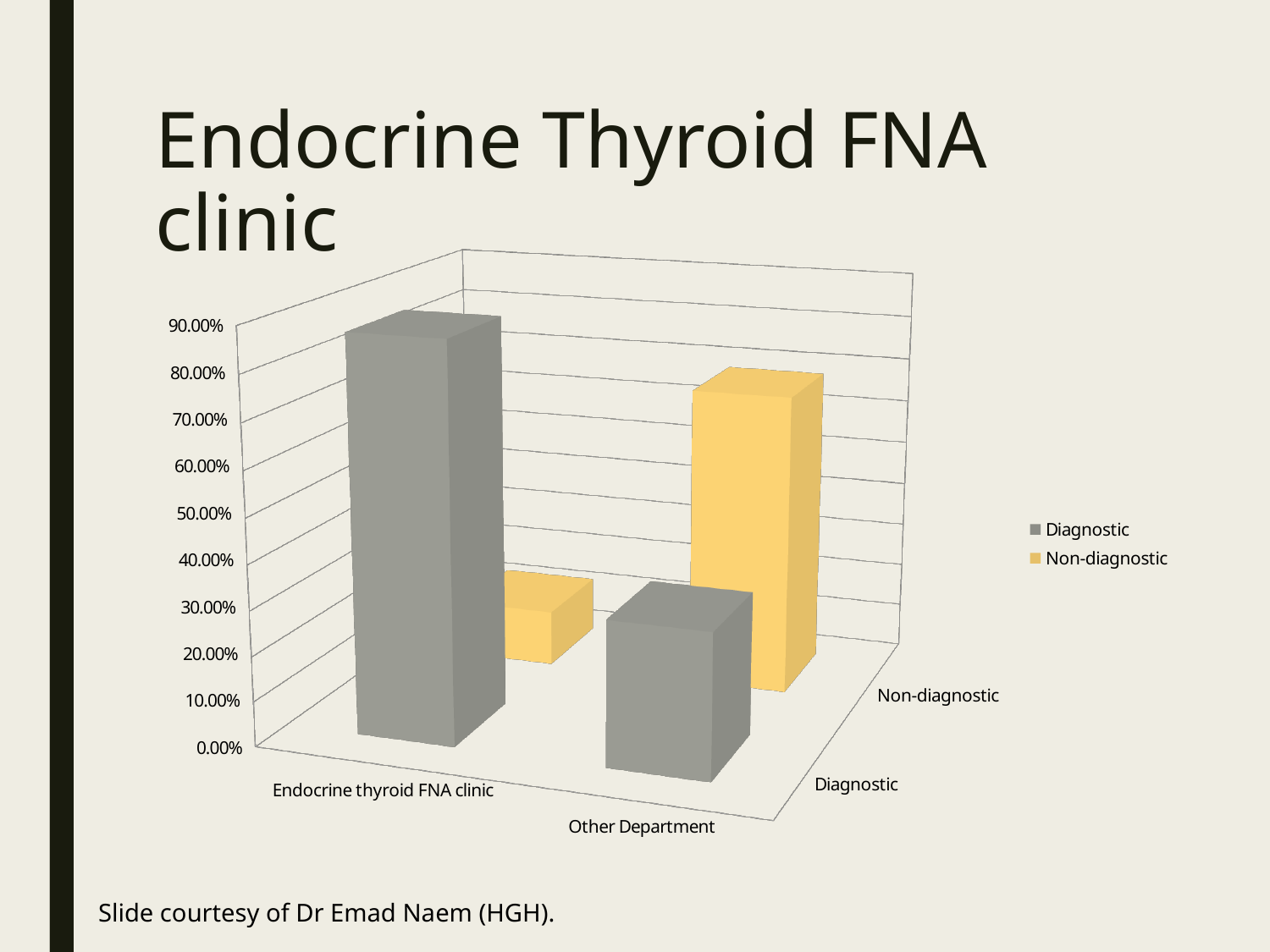
How many series does the legend list? 2 Which bar is the shortest in the chart? Non-diagnostic for Endocrine thyroid FNA clinic Which category has the higher Diagnostic value, Endocrine thyroid FNA clinic or Other Department? Endocrine thyroid FNA clinic Is the Diagnostic value for Endocrine thyroid FNA clinic greater or less than 70.00%? greater Which category has the higher Non-diagnostic value, Endocrine thyroid FNA clinic or Other Department? Other Department How many categories are shown along the x axis? 2 Which bar is the tallest in the chart? Diagnostic for Endocrine thyroid FNA clinic Is the Non-diagnostic value for Other Department greater or less than 50.00%? greater Which series is shown in grey in the legend? Diagnostic Is the Non-diagnostic value for Endocrine thyroid FNA clinic greater or less than 40.00%? less Which series is shown in yellow in the legend? Non-diagnostic What kind of chart is shown on the slide? bar chart